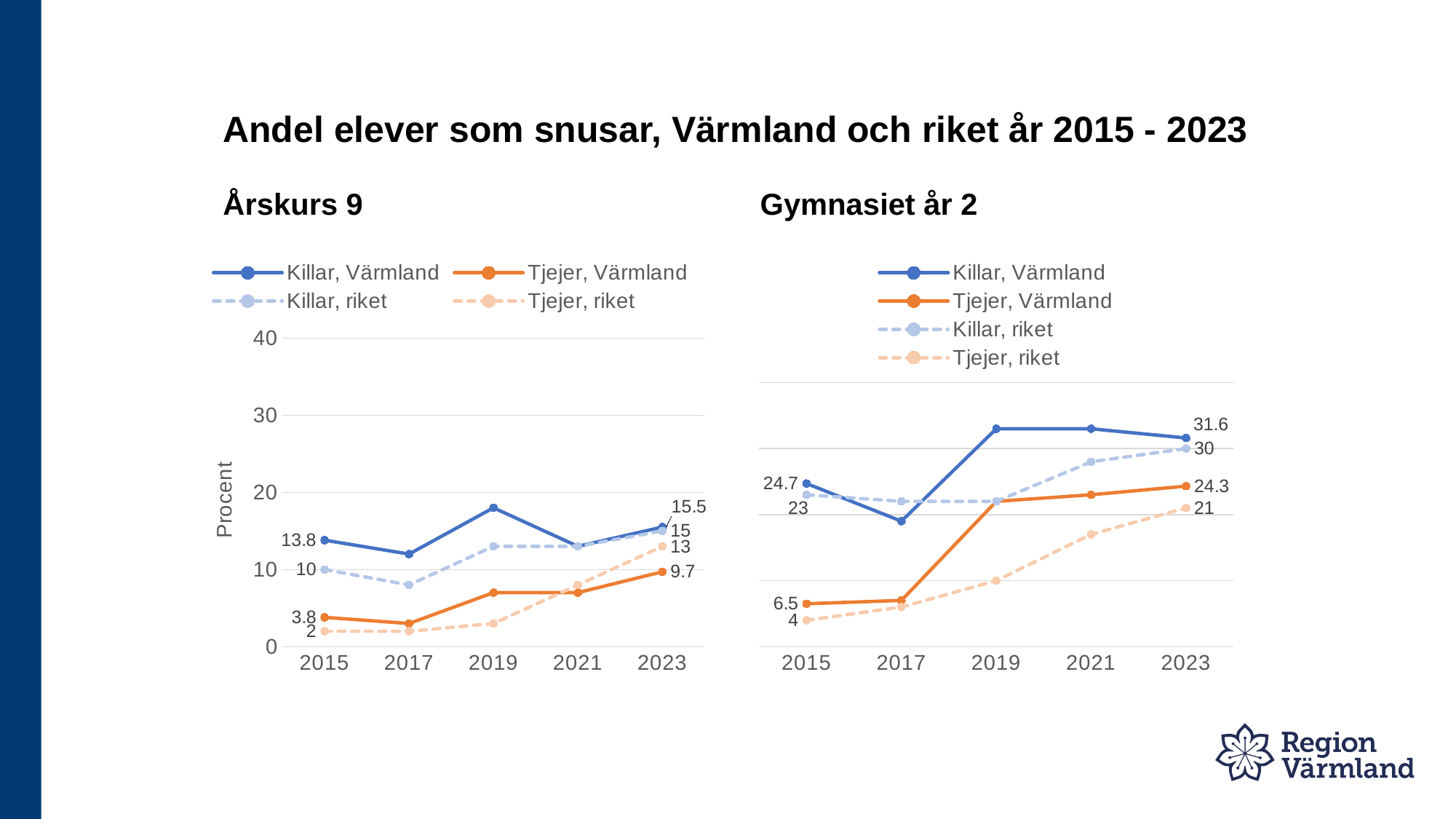
How many years are shown on the x axis of the Gymnasiet år 2 chart? 5 In the Gymnasiet år 2 chart, what is the value for Tjejer, Värmland in 2015? 6.5 How many series does the legend of the Gymnasiet år 2 chart list? 4 What kind of chart is the Årskurs 9 chart? Line chart In the Gymnasiet år 2 chart, what is the value for Killar, Värmland in 2023? 31.6 In the Gymnasiet år 2 chart, which series has the highest value in 2023? Killar, Värmland In the Gymnasiet år 2 chart, what is the difference between Tjejer, Värmland and Tjejer, riket in 2023? 3.3 In the Årskurs 9 chart, by how much did the value for Killar, Värmland change from 2015 to 2023? 1.7 In the Årskurs 9 chart, what is the value for Tjejer, riket in 2023? 13 In the Årskurs 9 chart, which is larger in 2023: Killar, riket or Tjejer, riket? Killar, riket In the Årskurs 9 chart, is the value for Killar, Värmland in 2019 greater or less than 20? less In the Årskurs 9 chart, what is the value for Killar, Värmland in 2015? 13.8